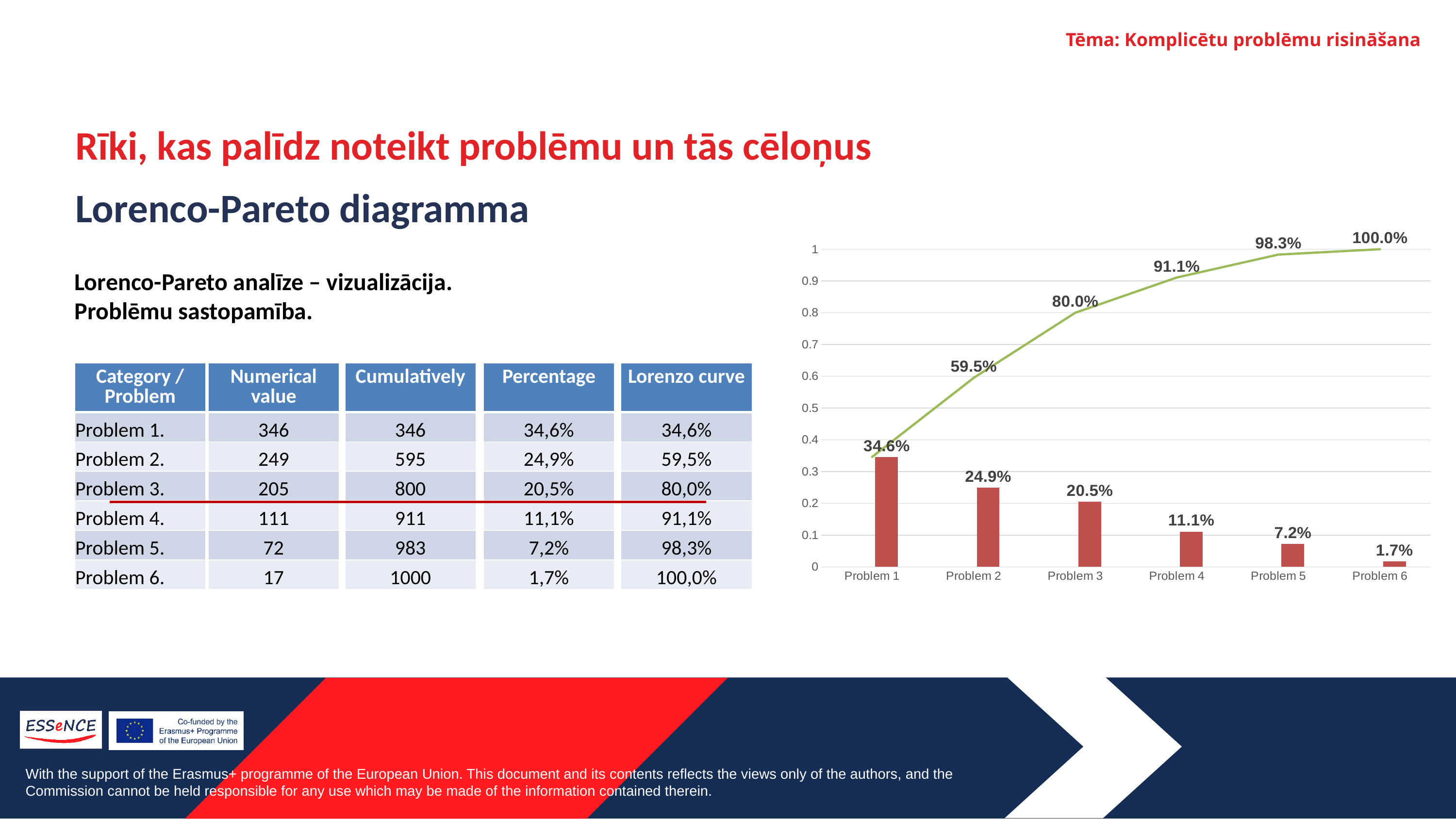
What kind of chart is shown on the slide? Combined bar and line chart (Pareto chart) Is the cumulative line value at Problem 2 greater or less than 0.5 on the axis? greater What colour is the cumulative line in the chart? green Which bar is larger in the chart, Problem 4 or Problem 5? Problem 4 How many problem categories are shown on the x axis of the chart? 6 Which problem has the lowest bar in the chart? Problem 6 Do the bar values rise or fall from Problem 1 to Problem 6 in the chart? fall What is the bar value for Problem 6 in the chart? 1.7% What is the cumulative line value at Problem 4 in the chart? 91.1% What is the difference between the bar values for Problem 1 and Problem 2 in the chart? 9.7% What is the bar value for Problem 3 in the chart? 20.5% Which problem has the highest bar in the chart? Problem 1